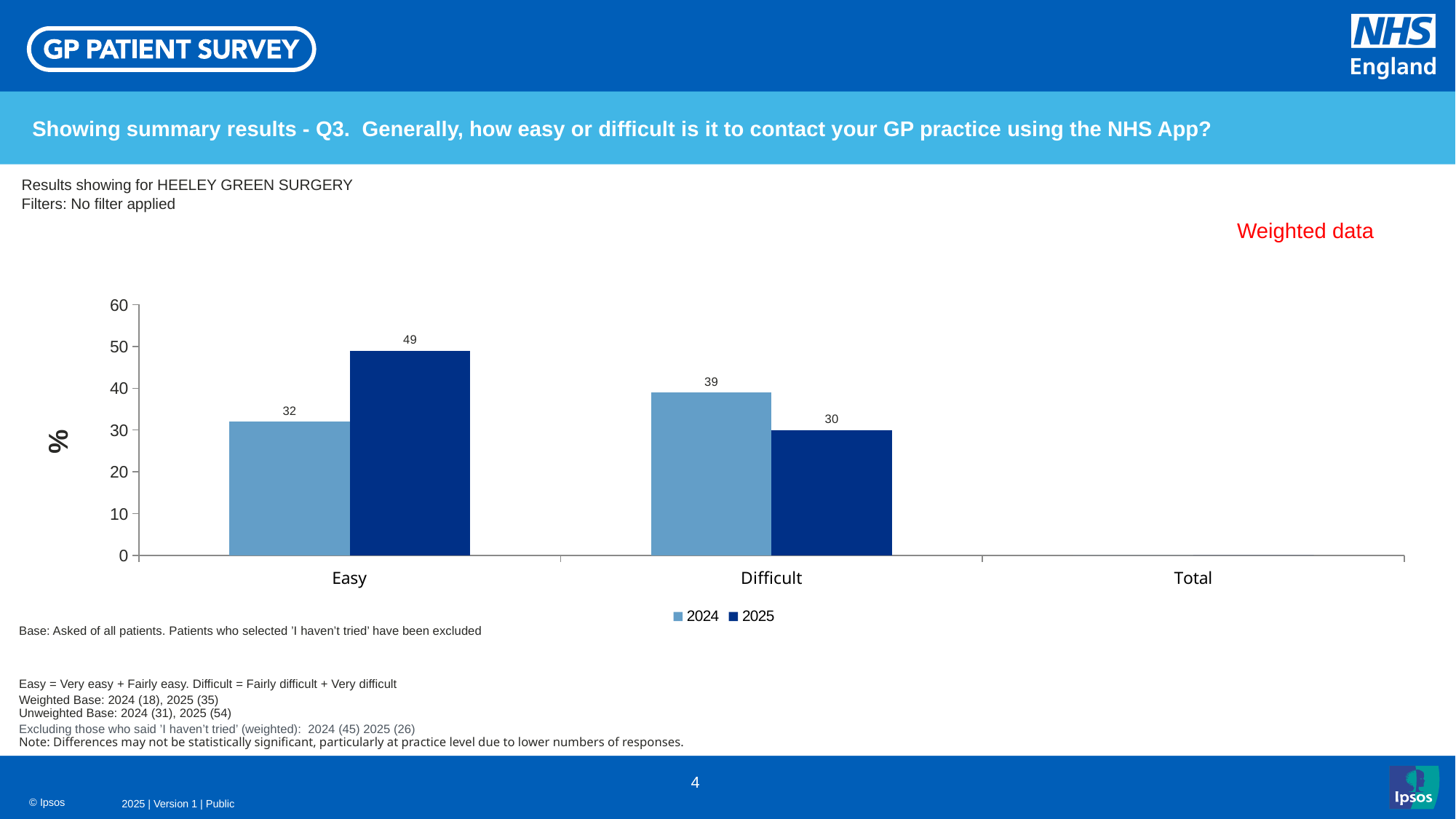
Which category has the lowest value in the 2024 series? Easy What is the value for Easy in 2025? 49 Which category has the highest value in the 2025 series? Easy What label is shown on the y axis of the chart? % What kind of chart is shown on the slide? Bar chart Which is larger: the 2024 value for Difficult or the 2025 value for Difficult? 2024 What is the difference between the 2024 and 2025 values for Difficult? 9 What is the difference between the 2025 and 2024 values for Easy? 17 What is the value for Easy in 2024? 32 What is the value for Difficult in 2024? 39 What is the value for Difficult in 2025? 30 How many series does the legend list? 2